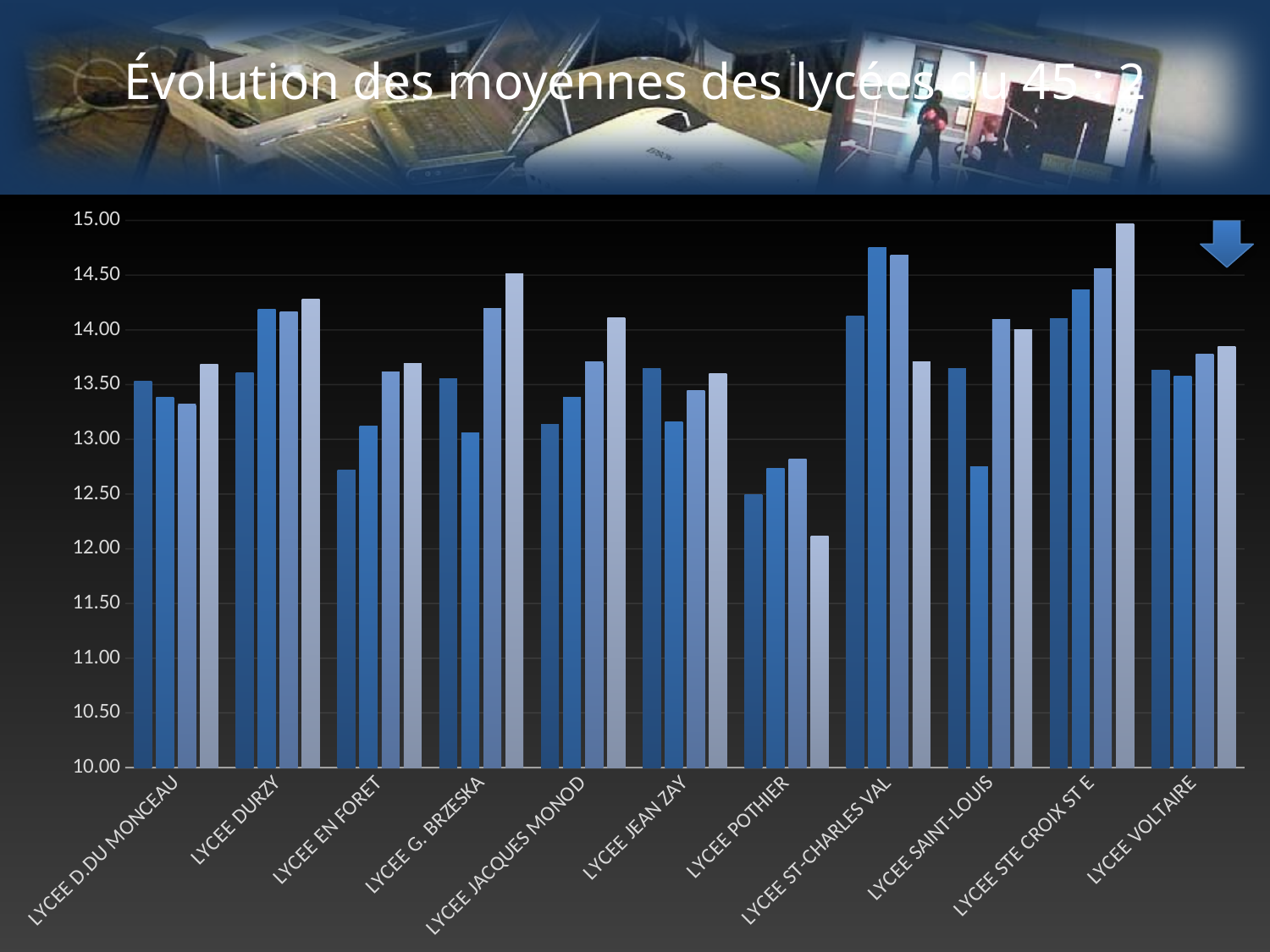
Is the value of the first bar for LYCEE EN FORET greater or less than 13.00? less Which lycée has the lowest bar in the chart? LYCEE POTHIER How many lycées (categories) are shown on the x axis of the chart? 11 Is the value of the fourth bar for LYCEE POTHIER greater or less than 12.50? less What kind of chart is shown on the slide? bar chart How many bars are plotted for each lycée in the chart? 4 Which is larger: the fourth bar for LYCEE POTHIER or the fourth bar for LYCEE STE CROIX ST E? LYCEE STE CROIX ST E Is the value of the fourth bar for LYCEE STE CROIX ST E greater or less than 14.50? greater What is the title of the slide containing the chart? Évolution des moyennes des lycées du 45 : 2 What is the highest value shown on the vertical axis of the chart? 15.00